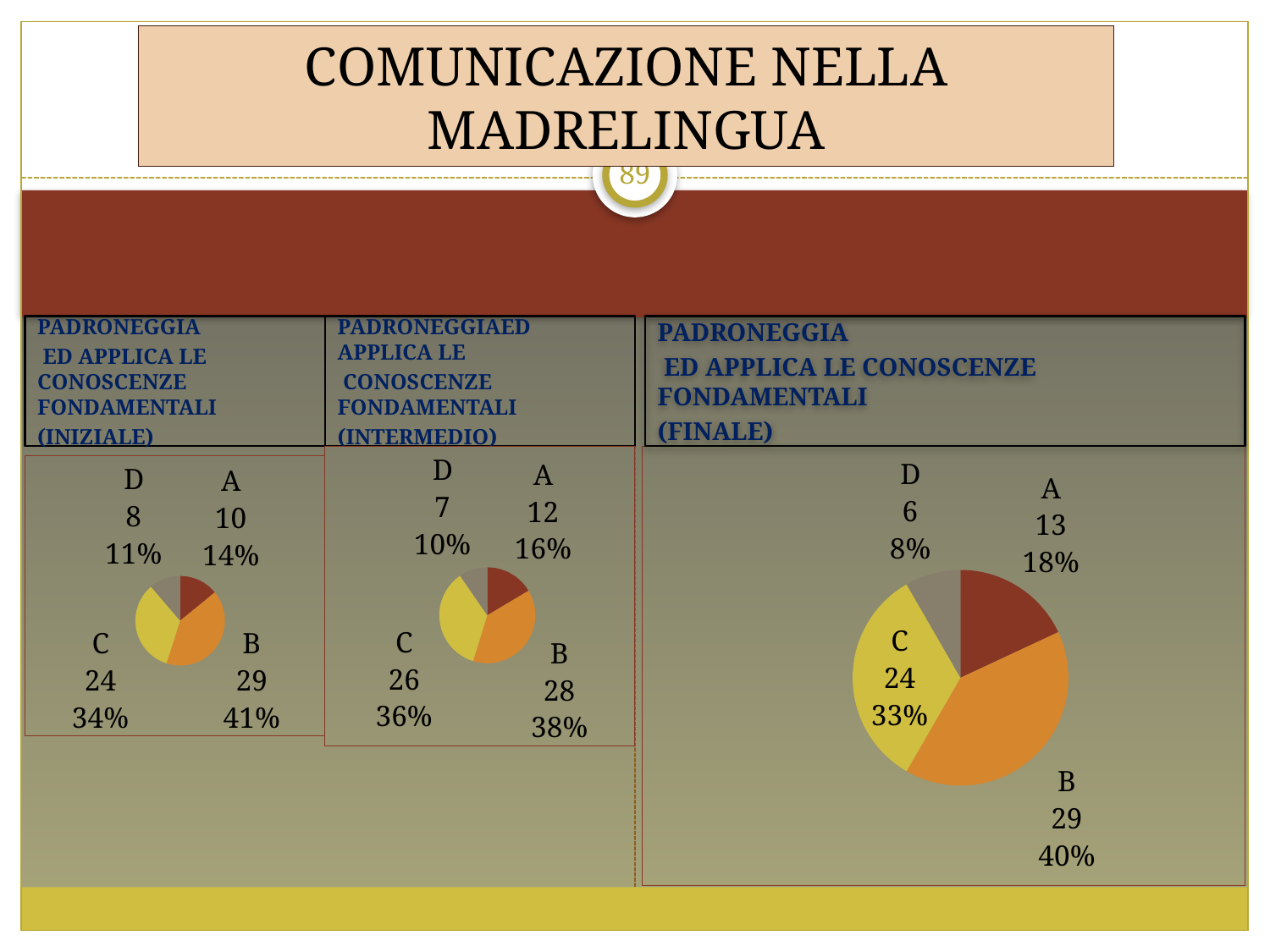
In the FINALE pie chart (right), which category has the largest slice? B In the INTERMEDIO pie chart (middle), what is the value for category D? 7 In the INTERMEDIO pie chart (middle), which category has the smallest slice? D In the FINALE pie chart (right), what share of the pie does category B represent? 40% What type of chart is used in the INIZIALE panel on the left? Pie chart In the FINALE pie chart (right), what is the difference between the values for B and C? 5 In the INIZIALE pie chart (left), which is larger, the value for A or the value for D? A How many categories are shown in the FINALE pie chart (right)? 4 In the INTERMEDIO pie chart (middle), what share of the pie does category A represent? 16% In the FINALE pie chart (right), what is the value for category A? 13 In the INIZIALE pie chart (left), what is the value for category B? 29 In the INIZIALE pie chart (left), what share of the pie does category C represent? 34%